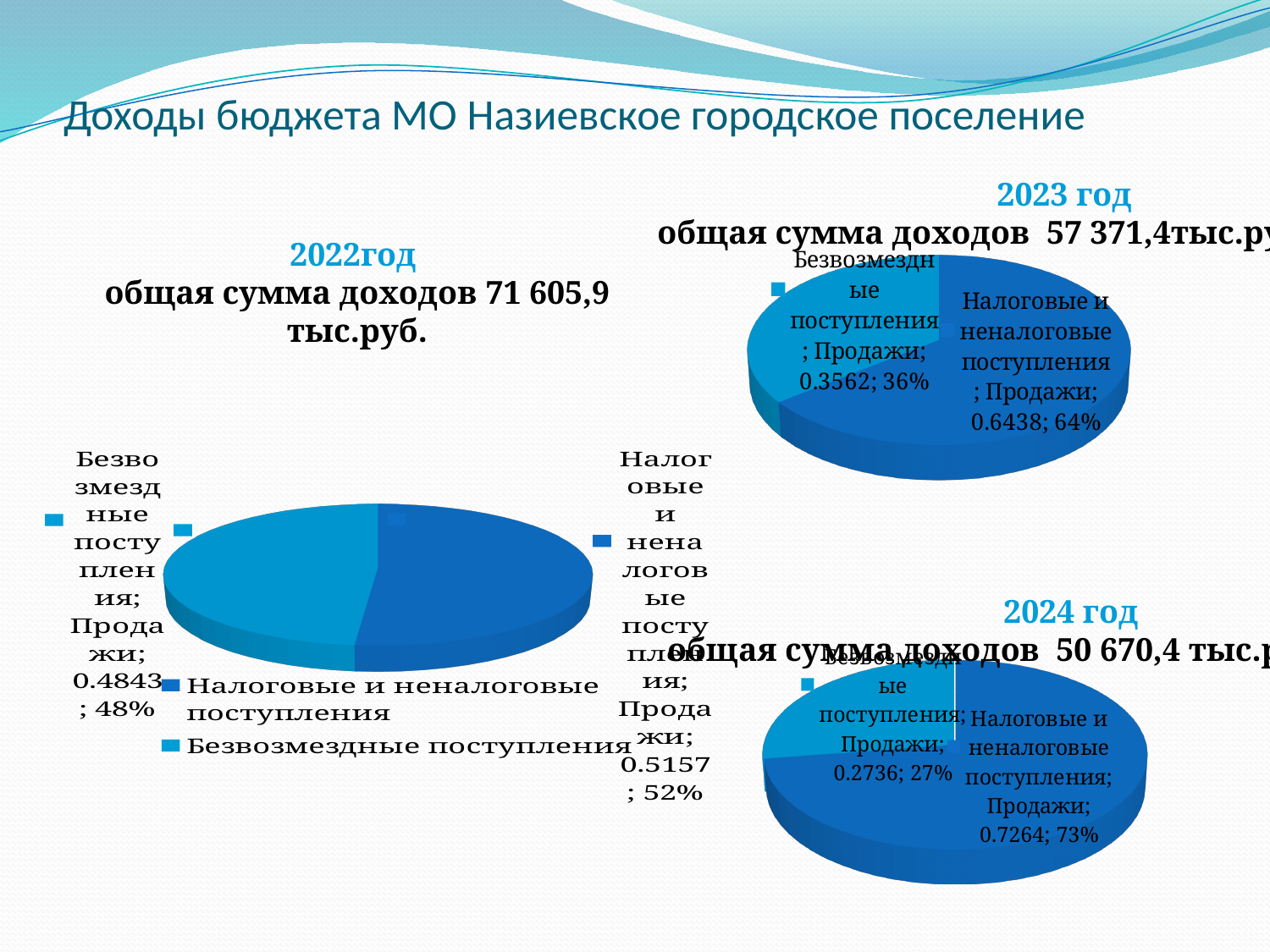
On the 2024 pie chart, what is the difference in percentage points between the two slices? 46% On the 2024 pie chart, what share is shown for Налоговые и неналоговые поступления? 73% On the 2023 pie chart, what share is shown for Безвозмездные поступления? 36% On the 2024 pie chart, what value is printed for Безвозмездные поступления? 0.2736 On the 2024 pie chart, which slice is the largest? Налоговые и неналоговые поступления On the 2022 pie chart, what share is shown for Безвозмездные поступления? 48% On the 2023 pie chart, what value is printed for Налоговые и неналоговые поступления? 0.6438 How many entries does the legend of the 2022 pie chart list? 2 How many slices does the 2023 pie chart have? 2 On the 2023 pie chart, which slice is the smallest? Безвозмездные поступления What kind of chart is used for the 2022 data? Pie chart